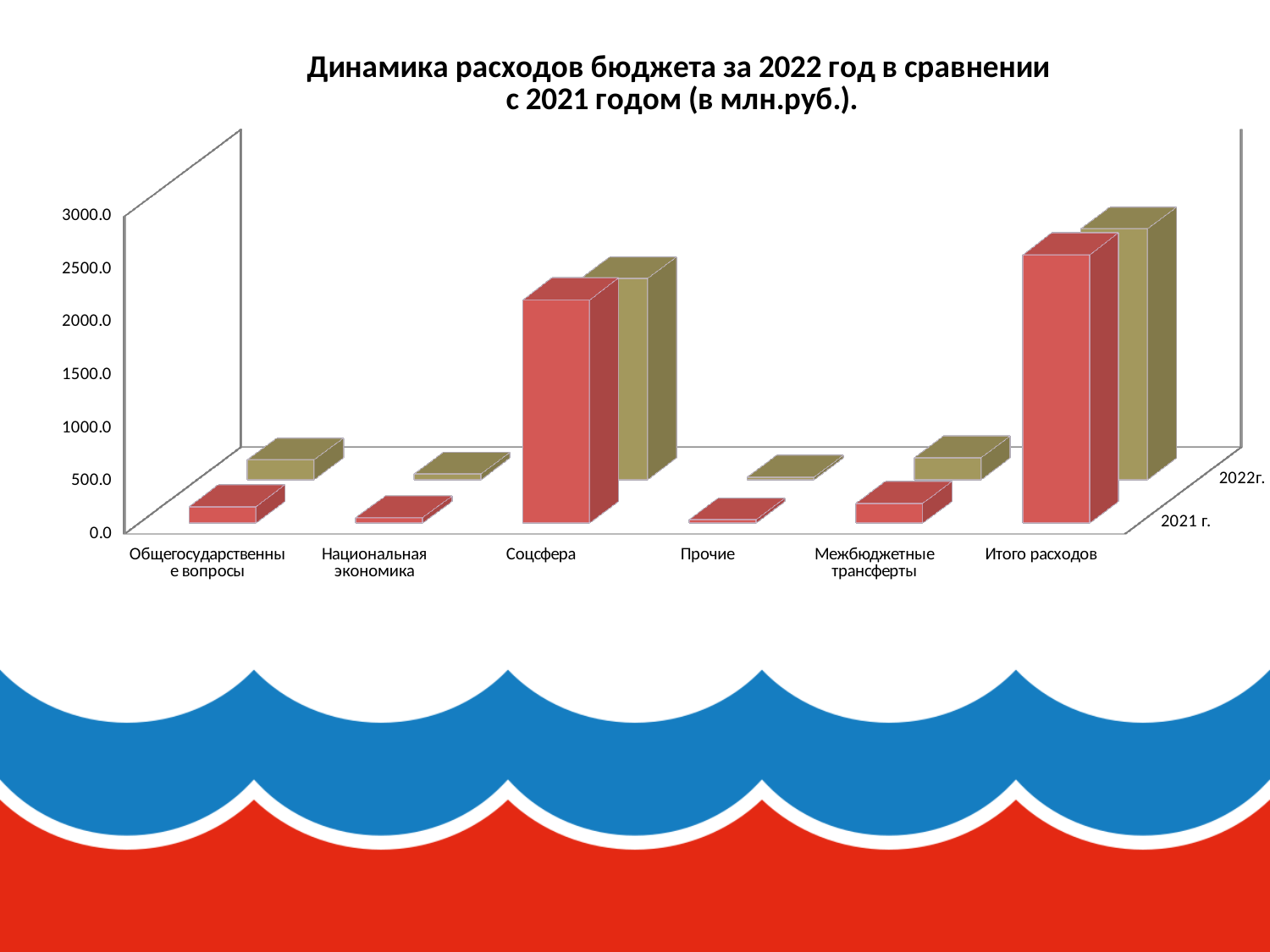
Is the 2021 г. value for Соцсфера greater or less than 1500.0? greater Which is larger for the 2021 г. series: Соцсфера or Межбюджетные трансферты? Соцсфера Is the 2021 г. value for Общегосударственные вопросы greater or less than 500.0? less Which category has the highest value for the 2021 г. series? Итого расходов What is the title of the chart? Динамика расходов бюджета за 2022 год в сравнении с 2021 годом (в млн.руб.). Which category has the lowest value for the 2021 г. series? Прочие How many series does the chart legend list? 2 What are the two series named in the chart legend? 2021 г. and 2022г. What kind of chart is shown on the slide? bar chart How many categories are shown on the x axis of the chart? 6 Is the 2021 г. value for Итого расходов greater or less than 2000.0? greater Which category has the highest value for the 2022г. series? Итого расходов